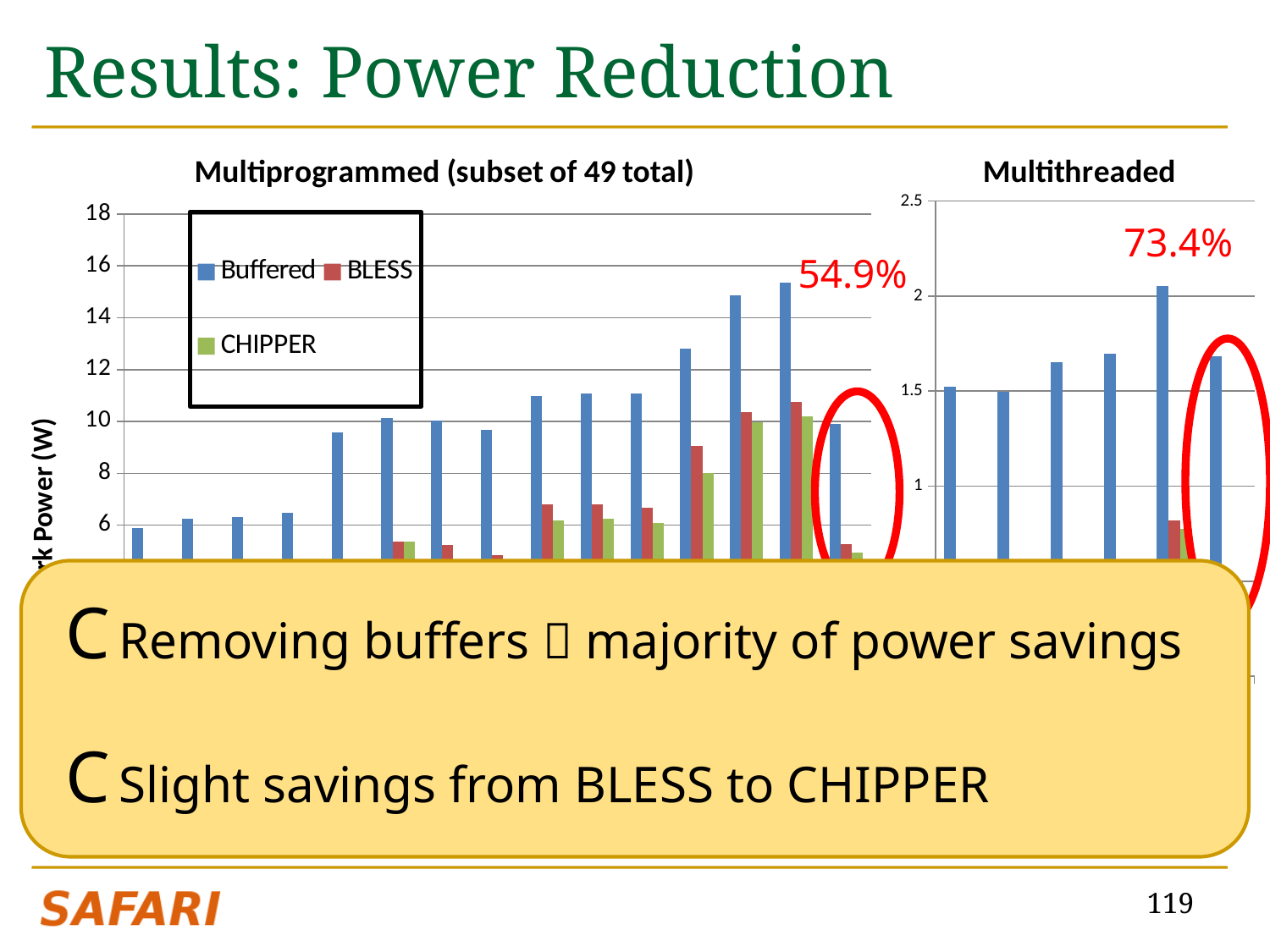
In the Multiprogrammed (subset of 49 total) chart, is the tallest Buffered bar greater or less than 14? greater In the Multiprogrammed (subset of 49 total) chart, which series has the tallest bars overall: Buffered or CHIPPER? Buffered What kind of chart is the Multithreaded chart? bar chart In the Multiprogrammed (subset of 49 total) chart, do the Buffered bars generally rise or fall from left to right? rise What percentage is annotated in red on the Multithreaded chart? 73.4% In the Multithreaded chart, is the leftmost bar greater or less than 1? greater In the Multithreaded chart, is the tallest bar greater or less than 1.5? greater In the Multiprogrammed (subset of 49 total) chart, how many series does the legend list? 3 What percentage is annotated in red on the Multiprogrammed (subset of 49 total) chart? 54.9% What kind of chart is the Multiprogrammed (subset of 49 total) chart? bar chart